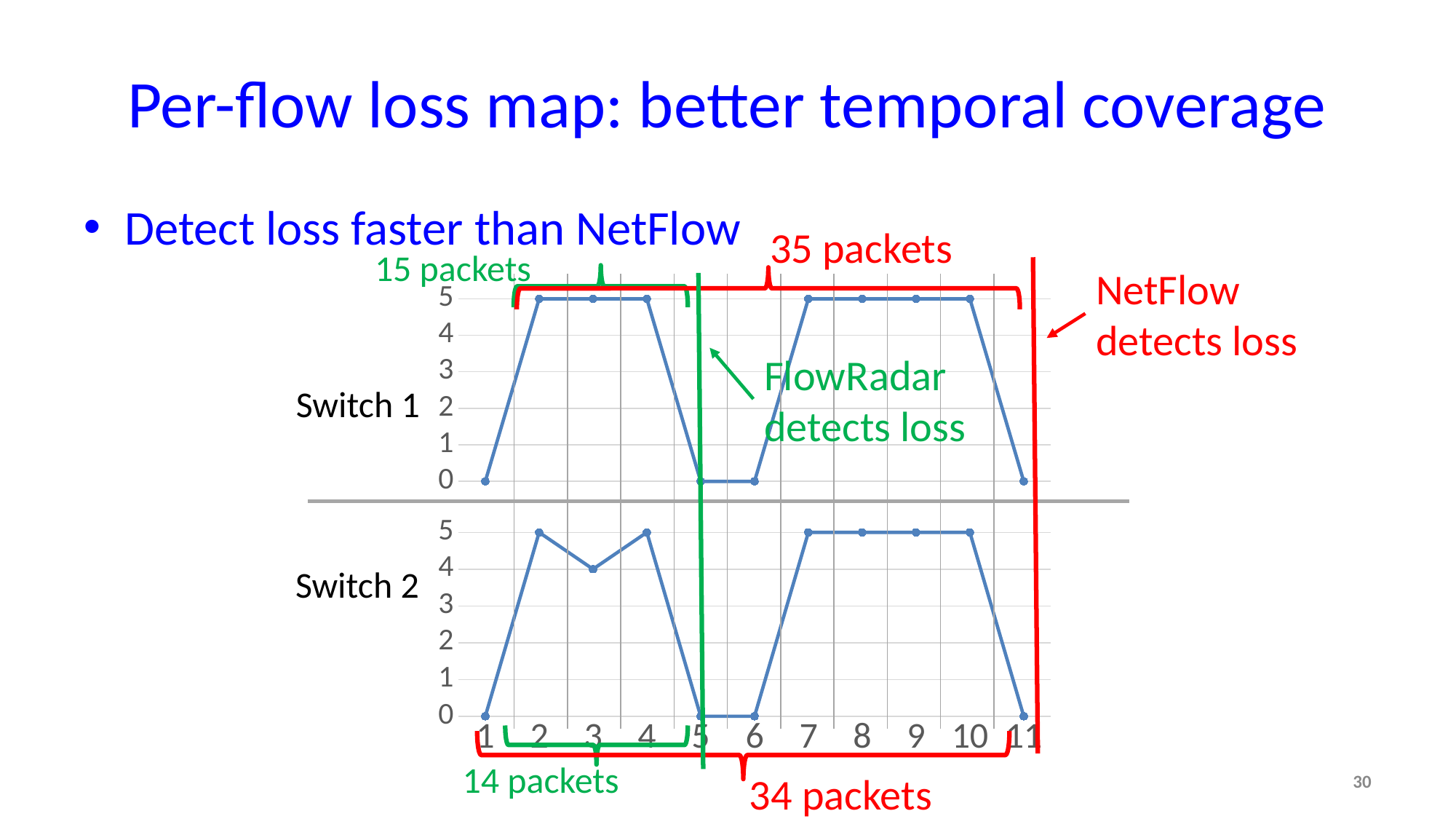
In the Switch 2 chart, what is the difference between the values at x = 2 and x = 3? 1 In the Switch 1 chart, what is the value at x = 6? 0 How many packets does the red bracket below the Switch 2 chart indicate? 34 packets In the Switch 2 chart, what is the value at x = 3? 4 In the Switch 1 chart, do the values rise or fall from x = 4 to x = 5? fall In the Switch 1 chart, what is the value at x = 3? 5 How many packets does the green bracket above the Switch 1 chart indicate? 15 packets How many data points are plotted in the Switch 2 chart? 11 In the Switch 2 chart, what is the value at x = 11? 0 In the Switch 1 chart, what is the lowest value plotted? 0 What kind of chart is used for Switch 1? line chart In the Switch 2 chart, which is larger, the value at x = 4 or the value at x = 5? x = 4